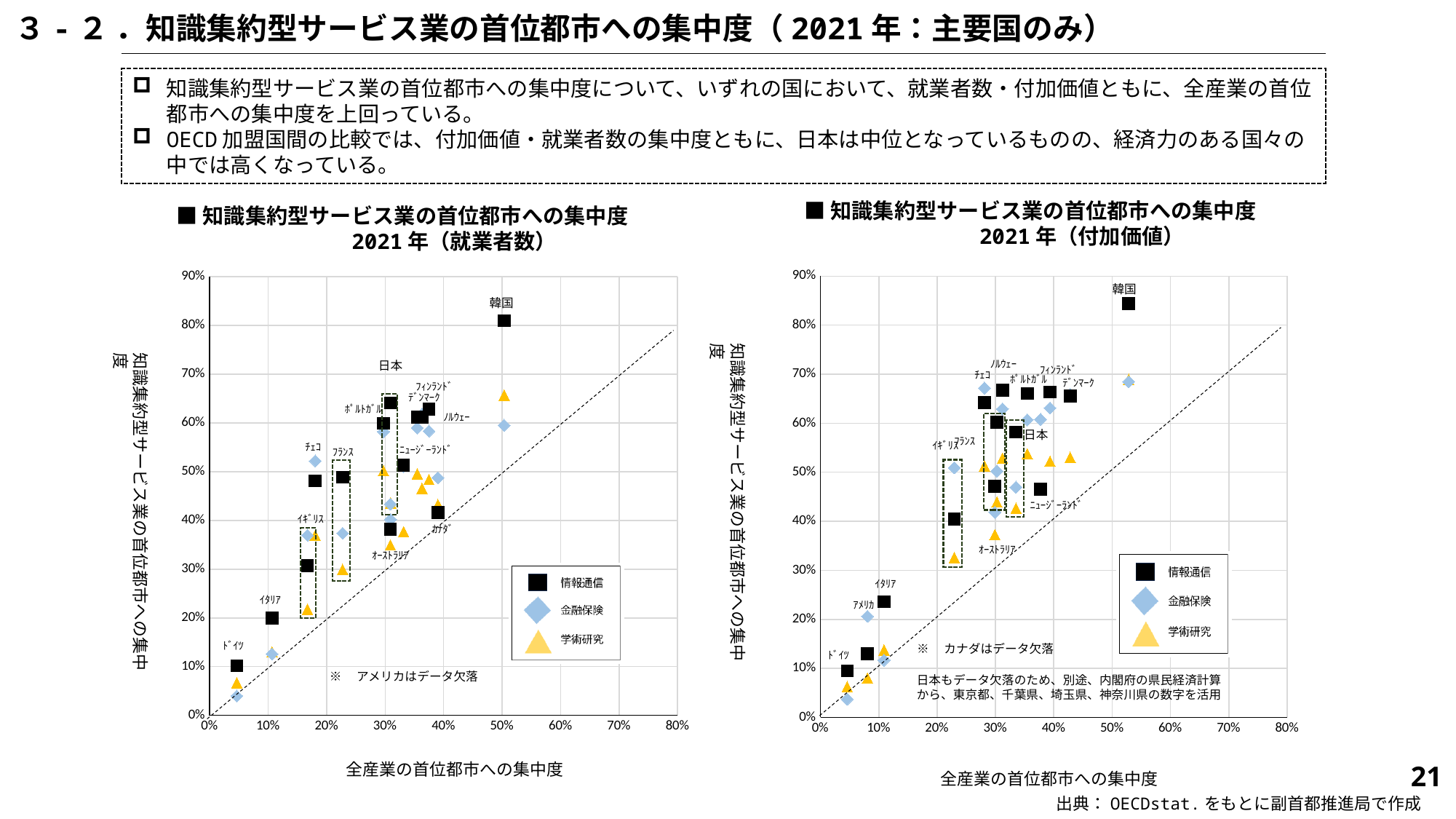
In the left chart (就業者数), which country's 情報通信 point is the highest on the y axis? 韓国 In the right chart (付加価値), is the y-axis value of the 韓国 情報通信 point greater or less than 80%? greater In the left chart (就業者数), is the y-axis value of the 日本 情報通信 point greater or less than 60%? greater In the left chart (就業者数), which country's point is the lowest on the y axis? ドイツ In the right chart (付加価値), which country's 情報通信 point is the highest on the y axis? 韓国 In the left chart (就業者数), which has the higher y-axis value: the 情報通信 point for 韓国 or for 日本? 韓国 What is the x-axis label of the right chart (付加価値)? 全産業の首位都市への集中度 What kind of chart is the left chart titled 知識集約型サービス業の首位都市への集中度 2021年（就業者数）? scatter chart In the right chart (付加価値), is the y-axis value of the イタリア 情報通信 point greater or less than 20%? greater How many series does the legend of the right chart (付加価値) list? 3